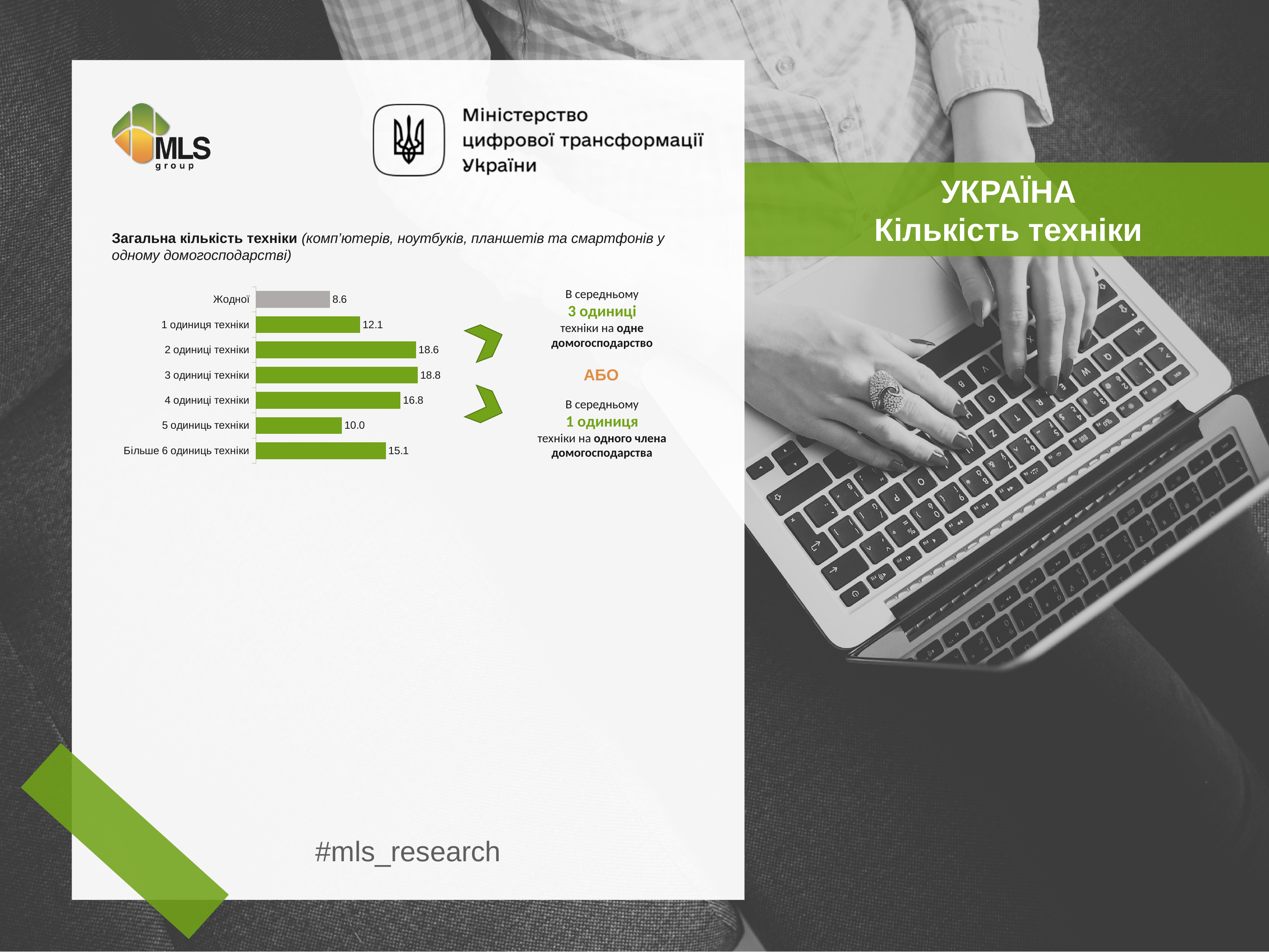
What is the value for "Більше 6 одиниць техніки"? 15.1 What is the difference between the values for "4 одиниці техніки" and "5 одиниць техніки"? 6.8 Which is larger: the value for "1 одиниця техніки" or "5 одиниць техніки"? 1 одиниця техніки What is the difference between the values for "3 одиниці техніки" and "Жодної"? 10.2 What is the value for "Жодної"? 8.6 What is the value for "3 одиниці техніки"? 18.8 Which category has the highest value? 3 одиниці техніки Which category has the lowest value? Жодної How many categories are shown in the chart? 7 What kind of chart is shown on the slide? Bar chart What colour is the bar for "Жодної"? Grey What is the value for "5 одиниць техніки"? 10.0